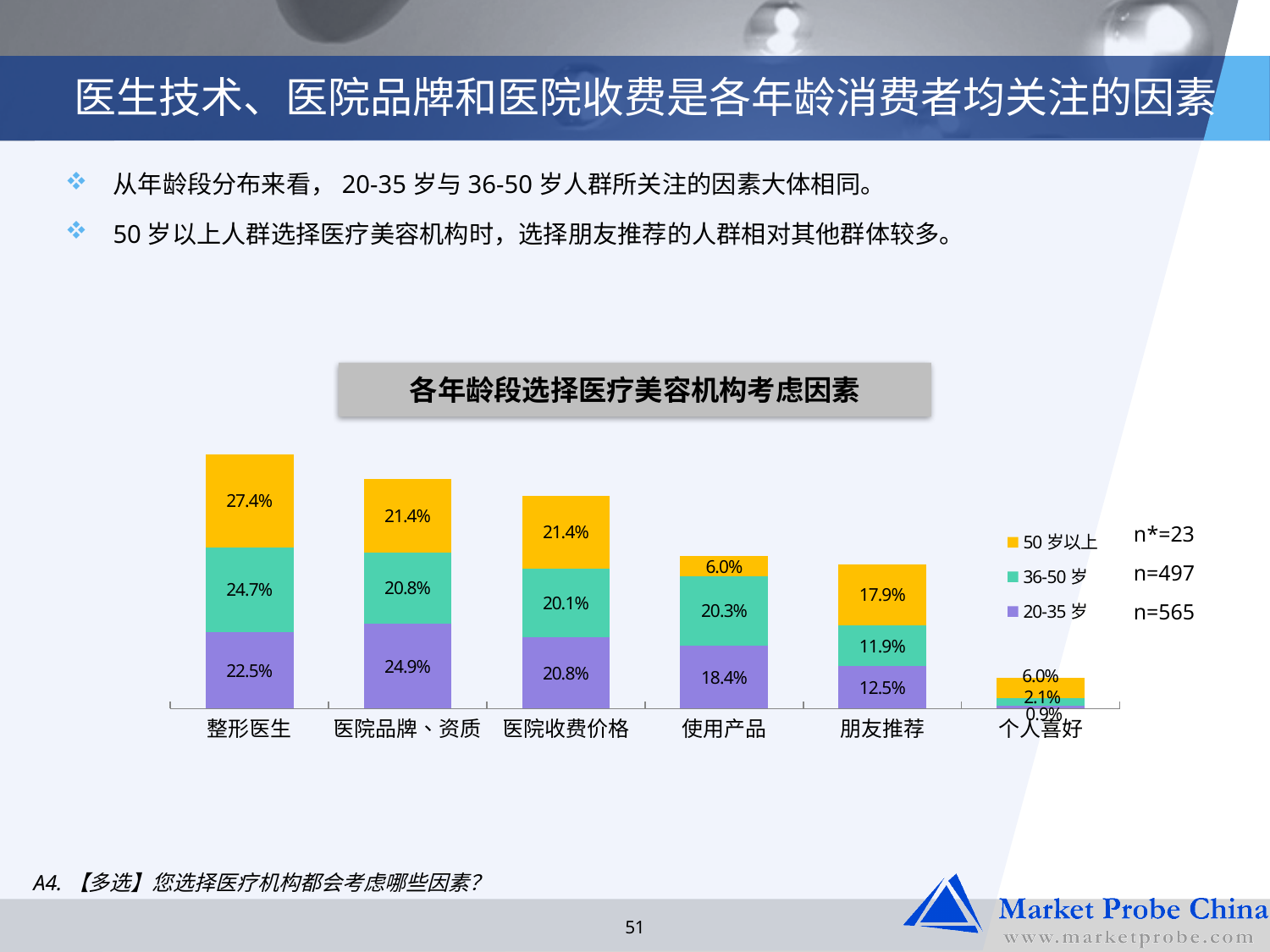
Which is larger in the 医院品牌、资质 category: the 20-35 岁 value or the 36-50 岁 value? 20-35 岁 Which category has the highest value for the 50 岁以上 series? 整形医生 What type of chart is shown on the slide? Stacked bar chart What is the total of the stacked bar for 个人喜好? 9.0% What is the title of the chart? 各年龄段选择医疗美容机构考虑因素 What is the value for 36-50 岁 in the 使用产品 category? 20.3% What is the difference between the 50 岁以上 value and the 20-35 岁 value in the 整形医生 category? 4.9% How many series does the chart legend list? 3 Which category has the lowest value for the 20-35 岁 series? 个人喜好 What is the value for 20-35 岁 in the 整形医生 category? 22.5% How many categories are shown on the x axis of the chart? 6 What is the value for 50 岁以上 in the 朋友推荐 category? 17.9%